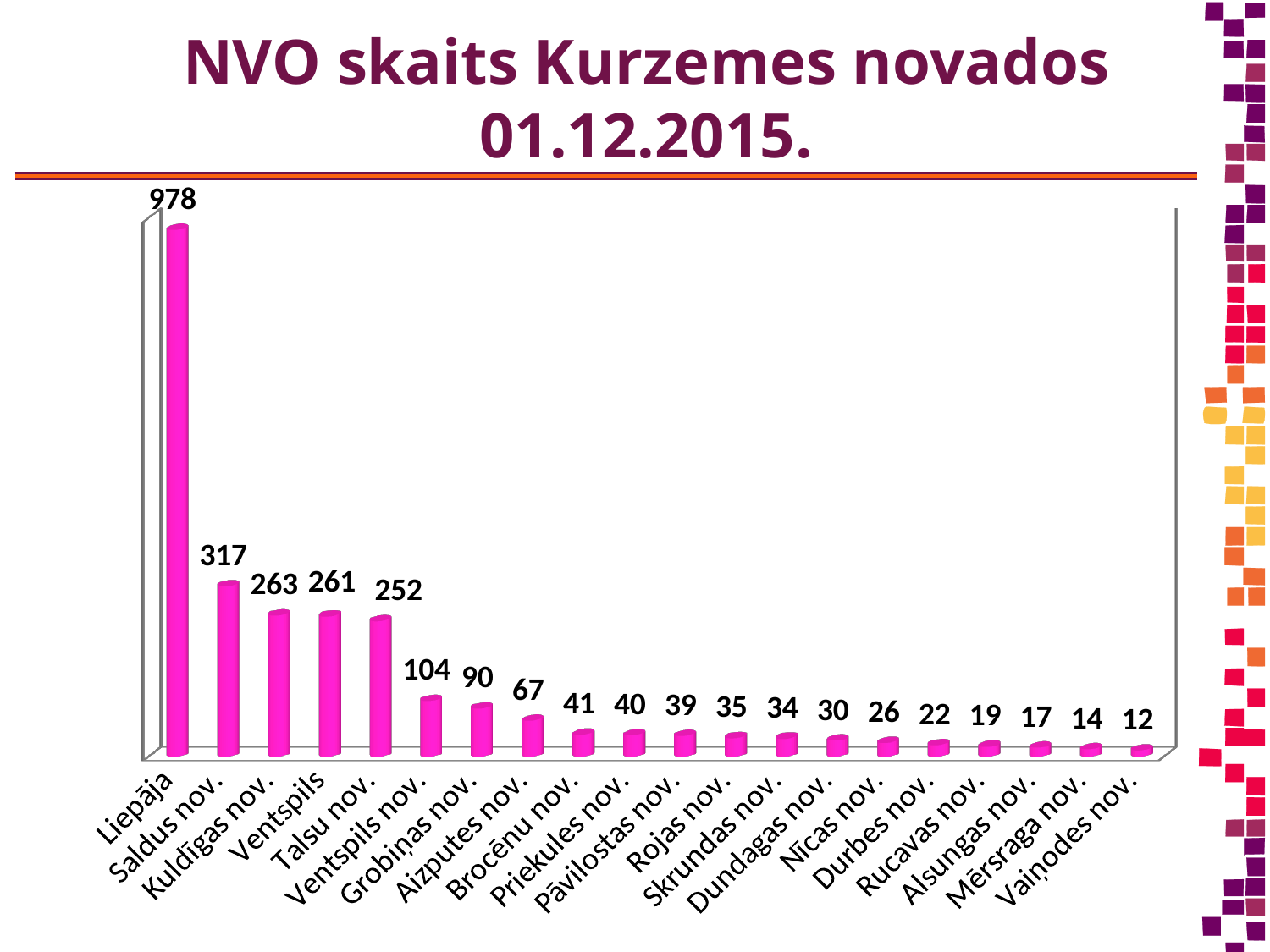
What is the value for Grobiņas nov.? 90 Which category has the lowest value? Vaiņodes nov. What kind of chart is this? bar chart What is the difference between the values for Liepāja and Saldus nov.? 661 Which is larger, the value for Kuldīgas nov. or the value for Ventspils? Kuldīgas nov. How many categories are shown on the x axis? 20 What is the value for Talsu nov.? 252 What is the value for Liepāja? 978 What is the difference between the values for Ventspils nov. and Aizputes nov.? 37 What is the value for Dundagas nov.? 30 Which category has the highest value? Liepāja Do the values rise or fall from left to right along the x axis? fall